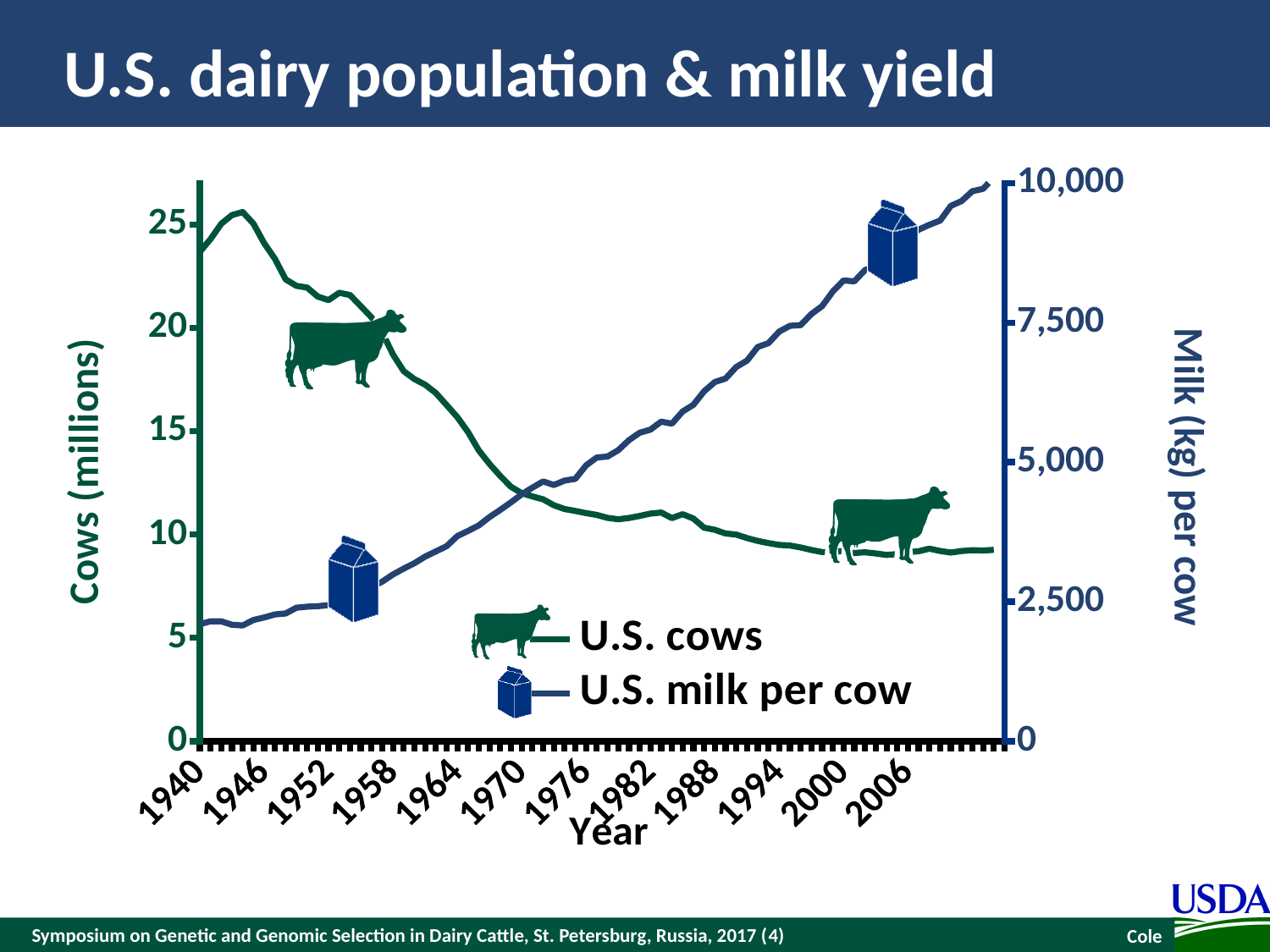
Does the U.S. cows series rise or fall from 1940 to 2006? fall Is the value for U.S. milk per cow in 1940 greater or less than 2,500 kg? less Is the value for U.S. cows in 1958 greater or less than 15 million? greater How many series does the legend list? 2 Does the U.S. milk per cow series rise or fall from 1940 to 2006? rise Is the value for U.S. cows in 1940 greater or less than 20 million? greater What kind of chart is shown on the slide? line chart What is the label of the right-hand vertical axis? Milk (kg) per cow What is the title of the chart? U.S. dairy population & milk yield